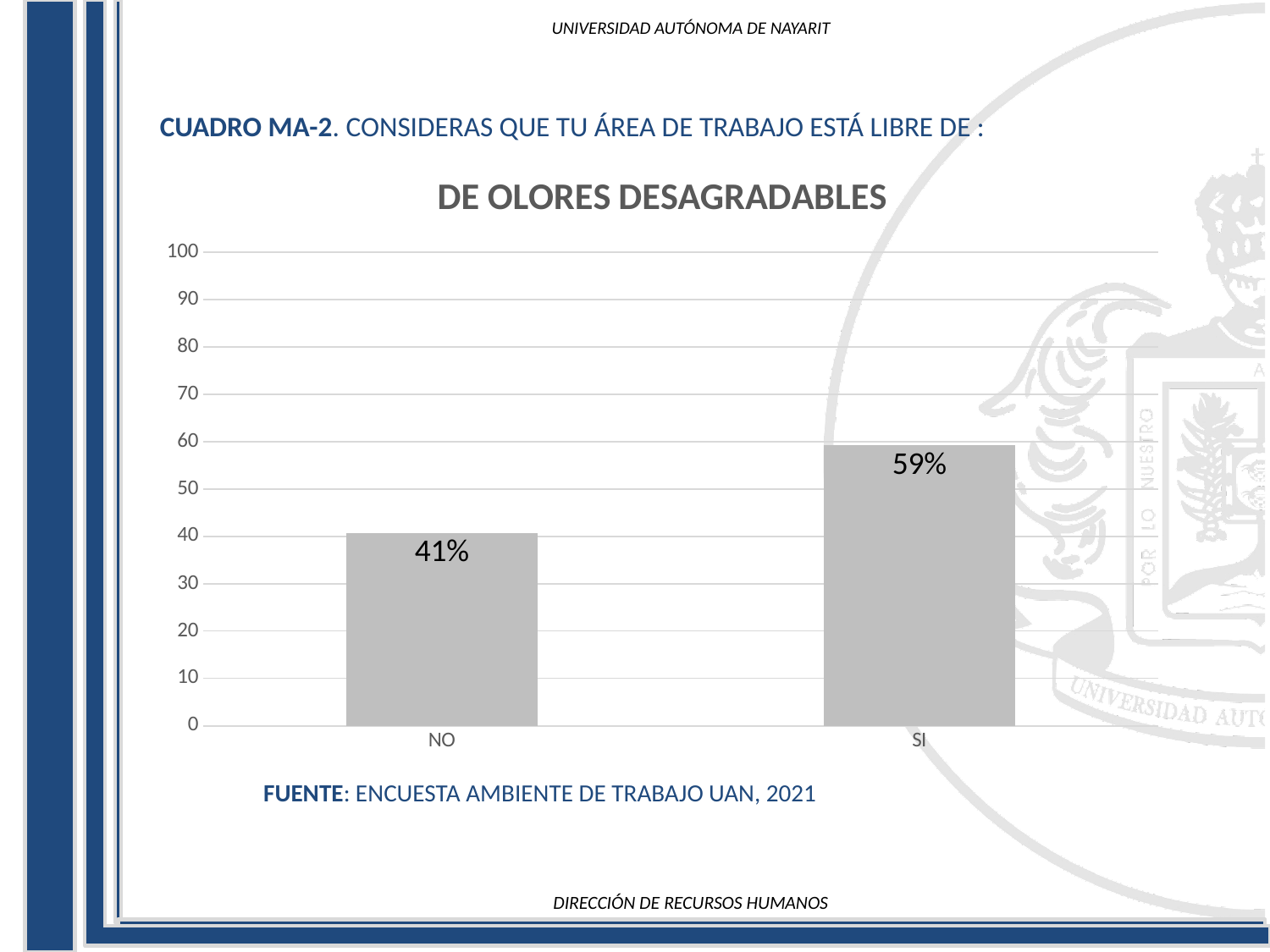
Which category has the lowest value? NO What is the maximum value shown on the y axis? 100 What kind of chart is shown? bar chart Is the value for NO greater or less than 50? less What is the value for SI? 59% Is the value for SI greater or less than 50? greater What is the value for NO? 41% Which is larger, the value for NO or the value for SI? SI Which category has the highest value? SI How many categories are shown on the x axis? 2 What is the difference between the values for SI and NO? 18% What is the title of the chart? DE OLORES DESAGRADABLES